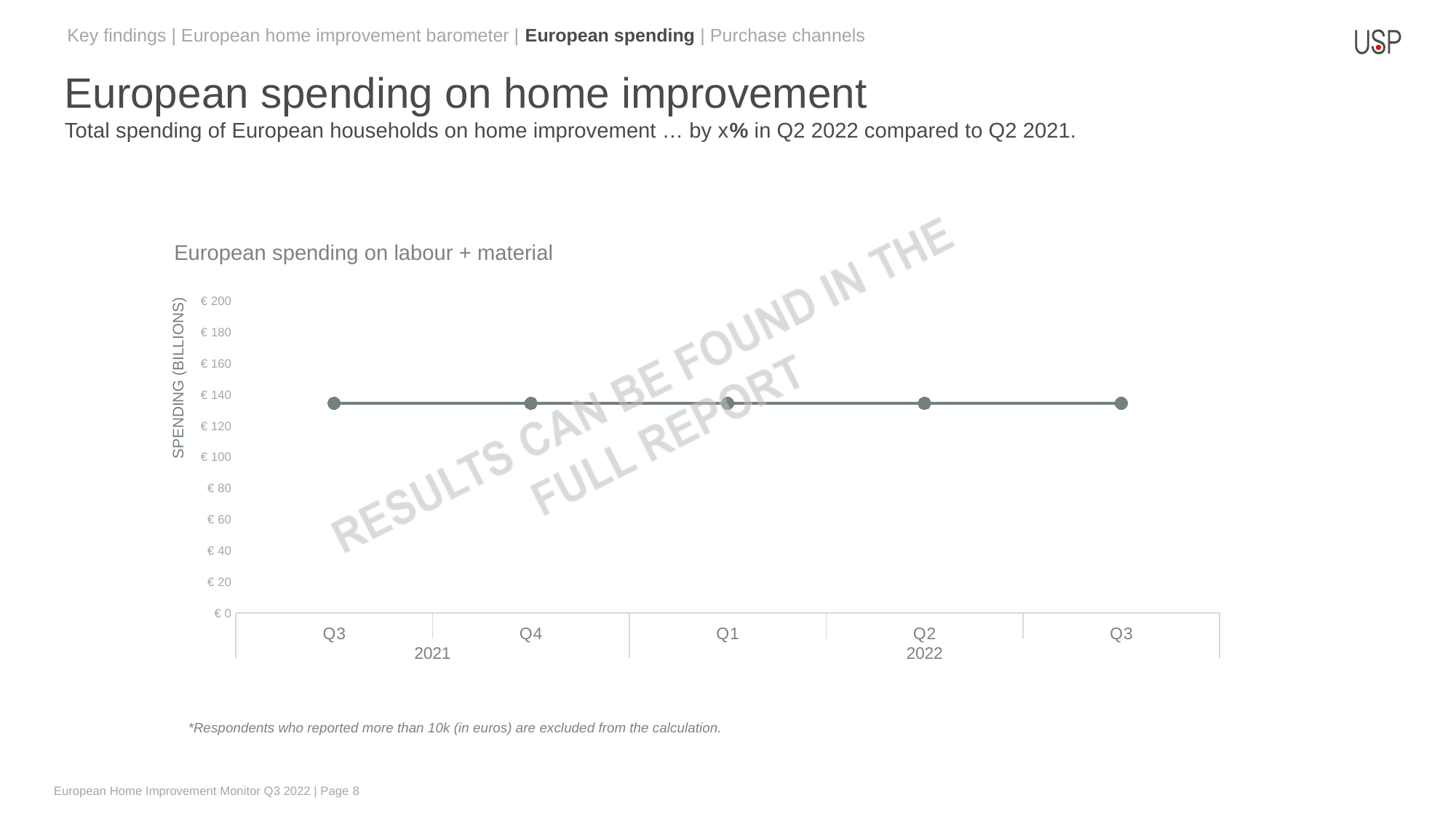
What is the title of the chart? European spending on labour + material Is the value for Q4 2021 greater or less than € 120? greater Is the value for Q3 2021 greater or less than € 160? less What is the highest tick value shown on the vertical axis? € 200 Is the value for Q2 2022 greater or less than € 100? greater How many data points are plotted on the chart? 5 Do the plotted values rise, fall or stay flat from Q3 2021 to Q3 2022? stay flat What is the label on the vertical axis of the chart? SPENDING (BILLIONS) What kind of chart is shown on the slide? line chart